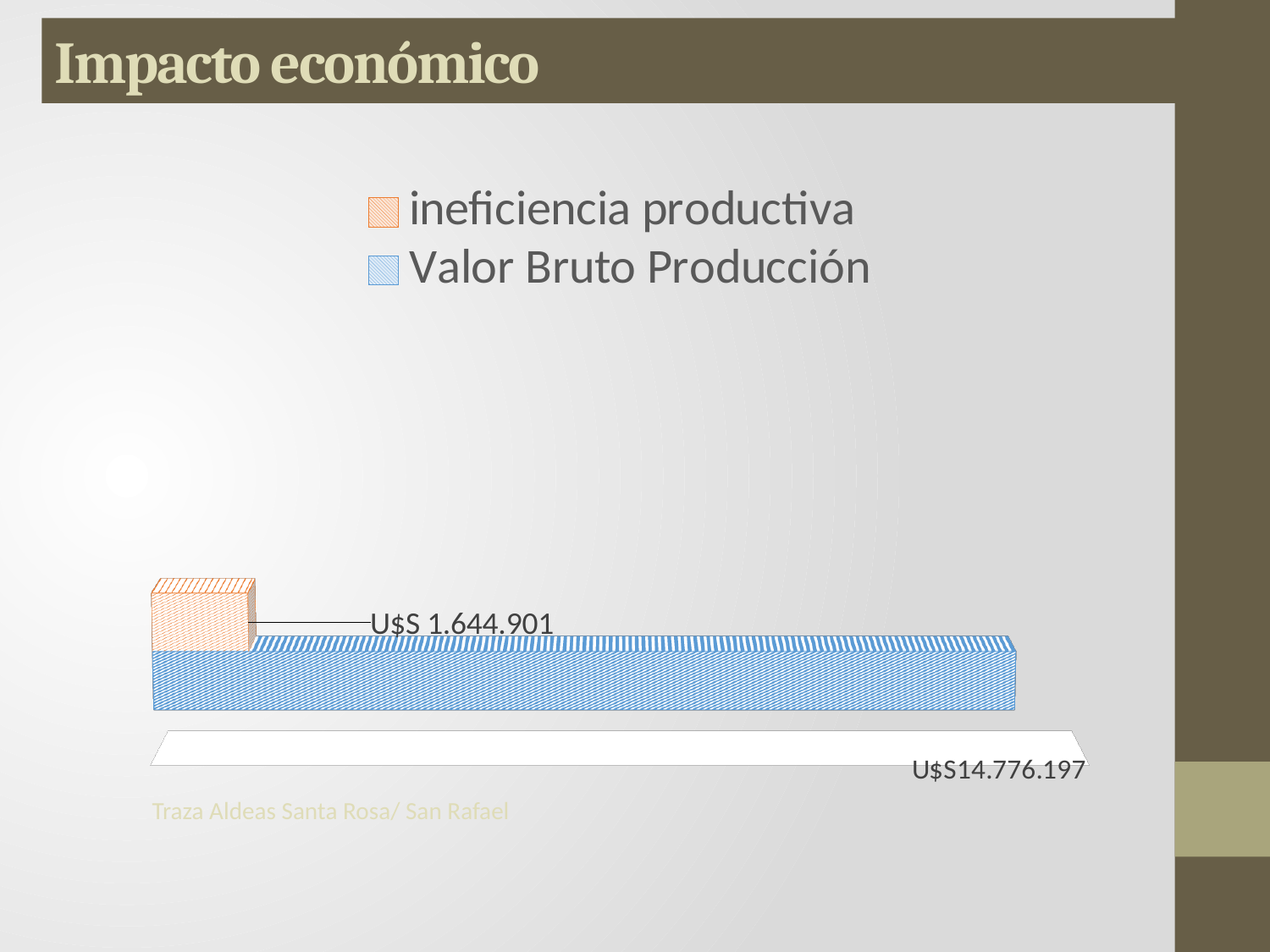
How many series does the legend list? 2 What kind of chart is shown on the slide? Bar chart Which series has the largest value? Valor Bruto Producción What is the category label shown below the bars? Traza Aldeas Santa Rosa/ San Rafael What is the value for Valor Bruto Producción? U$S14.776.197 How many categories are plotted on the chart? 1 What is the value for ineficiencia productiva? U$S 1.644.901 Which series has the larger value, ineficiencia productiva or Valor Bruto Producción? Valor Bruto Producción What is the difference between Valor Bruto Producción and ineficiencia productiva? U$S 13.131.296 Which colour represents Valor Bruto Producción in the legend? Blue Which series has the smallest value? ineficiencia productiva